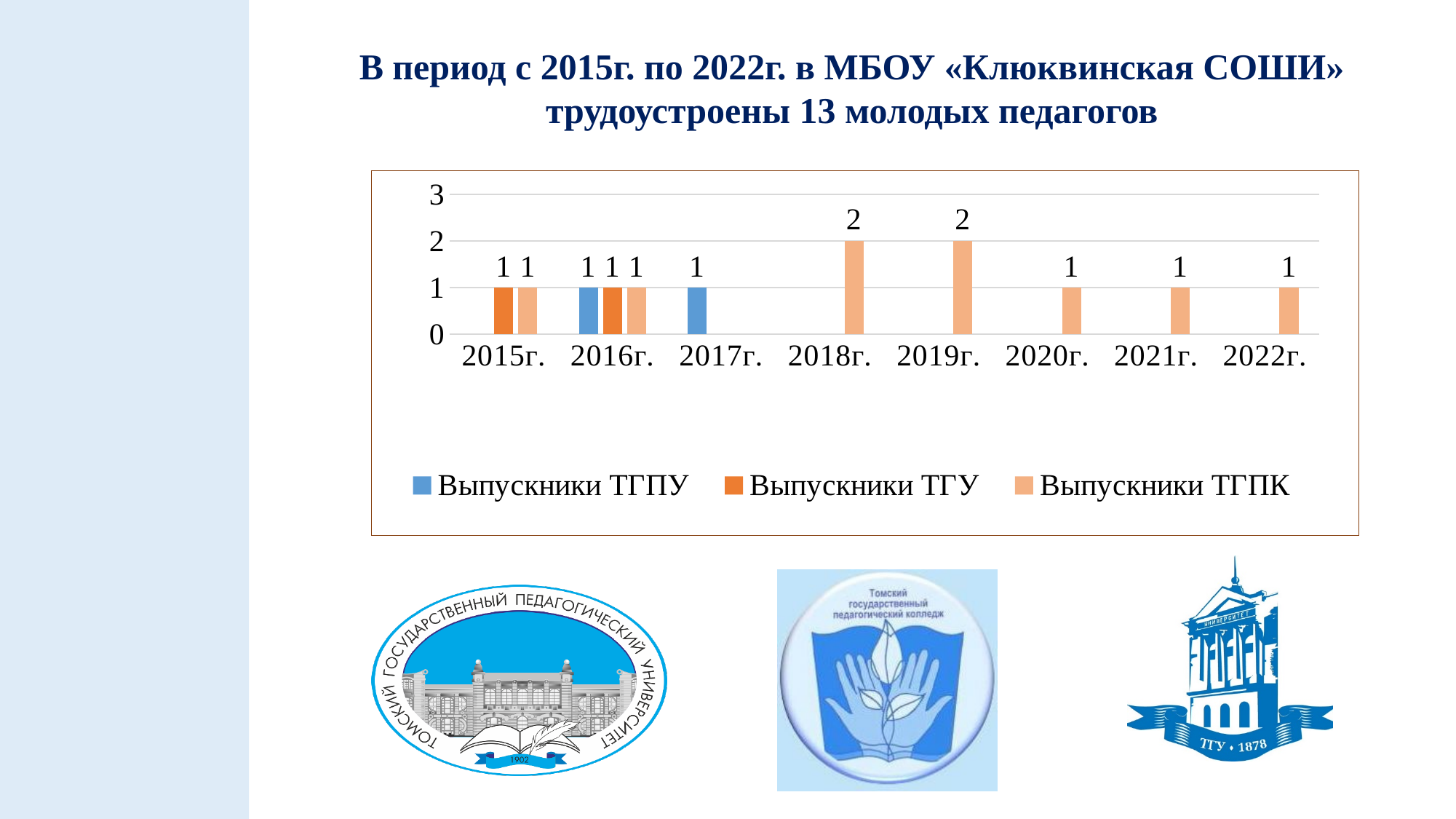
What is the value for Выпускники ТГПУ in 2017г.? 1 Which series is shown in blue in the chart legend? Выпускники ТГПУ Which is larger: the Выпускники ТГПК value in 2018г. or in 2022г.? 2018г. Which series is the only one with bars from 2018г. through 2022г.? Выпускники ТГПК How many series does the chart legend list? 3 How many year categories are shown on the x axis of the chart? 8 What is the total number of young teachers hired in 2016г. across all three series? 3 What is the difference between the Выпускники ТГПК value in 2019г. and in 2020г.? 1 What kind of chart is shown on the slide? Bar chart What is the value for Выпускники ТГПК in 2018г.? 2 In which years does the Выпускники ТГПК series reach its highest value? 2018г. and 2019г. What is the value for Выпускники ТГУ in 2016г.? 1